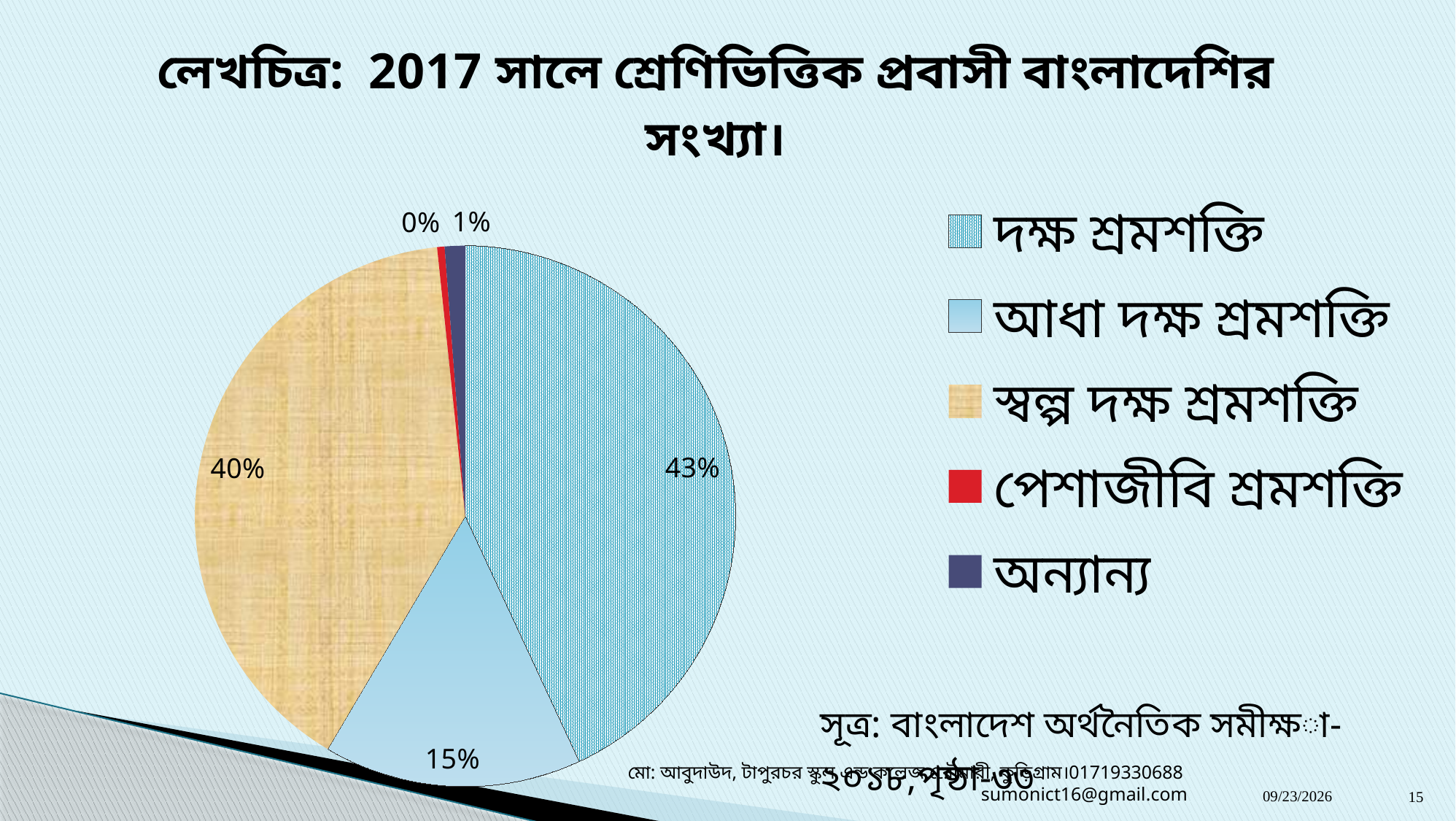
What share of the pie does আধা দক্ষ শ্রমশক্তি have? 15% Which category has the smallest slice of the pie? পেশাজীবি শ্রমশক্তি What is the difference in percentage points between দক্ষ শ্রমশক্তি and আধা দক্ষ শ্রমশক্তি? 28 What share of the pie does দক্ষ শ্রমশক্তি have? 43% What share of the pie does অন্যান্য have? 1% What kind of chart is shown on the slide? pie chart Which is larger, the slice for স্বল্প দক্ষ শ্রমশক্তি or the slice for আধা দক্ষ শ্রমশক্তি? স্বল্প দক্ষ শ্রমশক্তি How many categories does the legend list? 5 What colour is the slice for পেশাজীবি শ্রমশক্তি? red Which category has the largest slice of the pie? দক্ষ শ্রমশক্তি